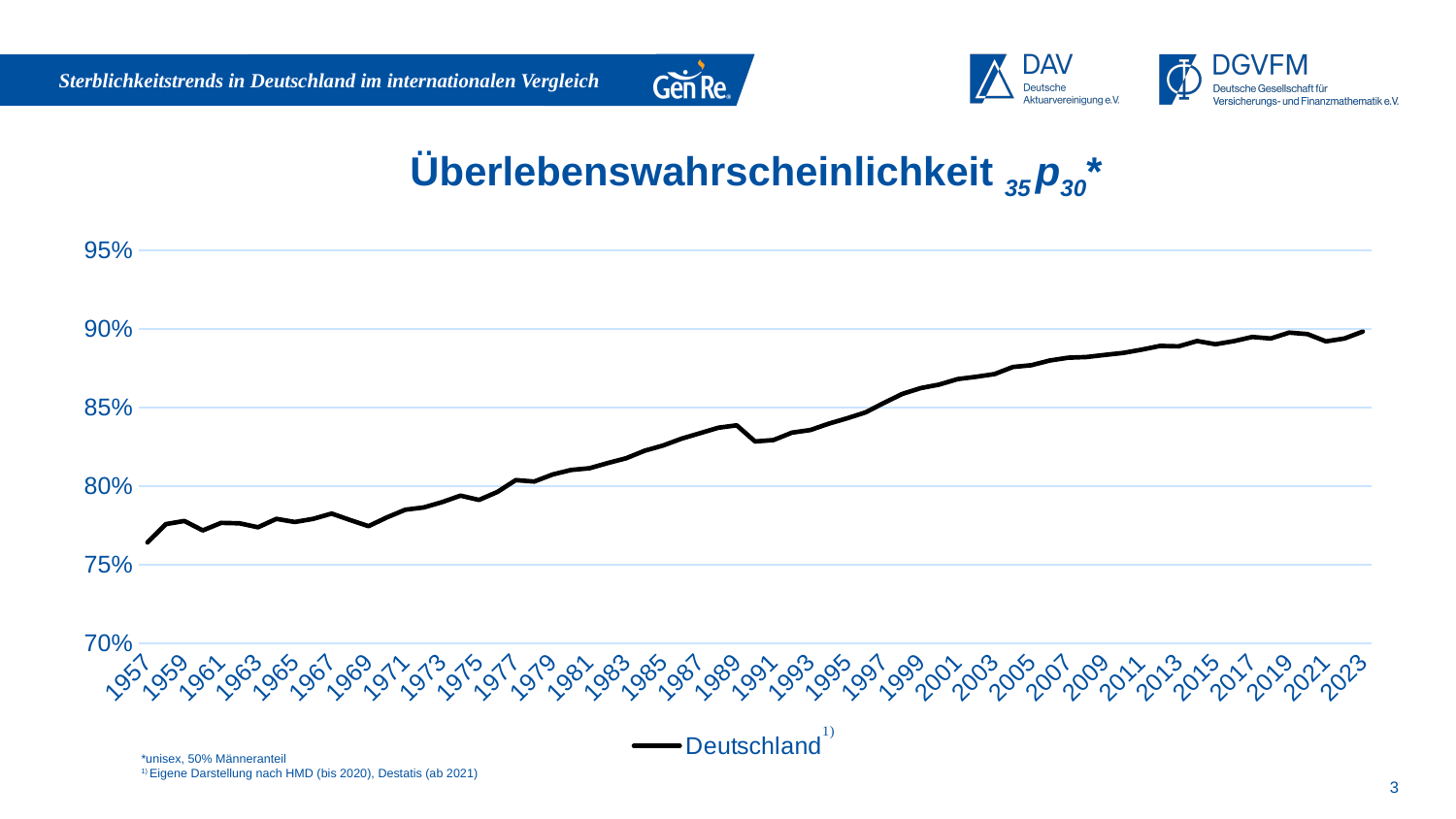
Which is larger, the value for Deutschland in 1957 or in 2023? 2023 What is the name of the series shown in the legend? Deutschland Is the value for Deutschland in 2001 greater or less than 85%? greater What kind of chart is shown on the slide? line chart Do the values for Deutschland generally rise or fall from 1957 to 2023? rise Is the value for Deutschland in 1975 greater or less than 80%? less Is the value for Deutschland in 2023 greater or less than 85%? greater How many series does the legend list? 1 What is the title of the chart? Überlebenswahrscheinlichkeit 35p30* Which year has the lowest value for Deutschland? 1957